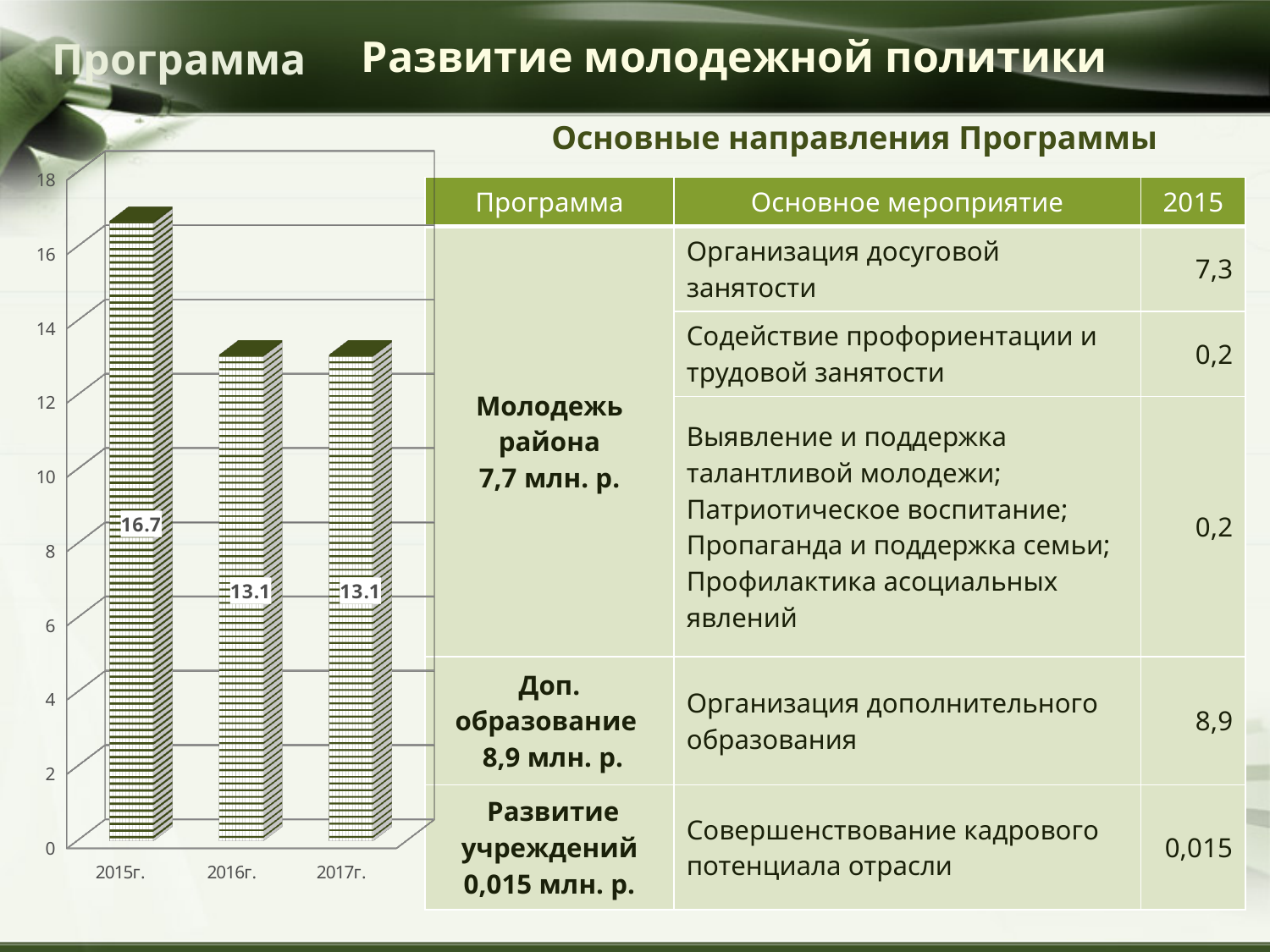
Do the values rise or fall from 2015г. to 2016г.? fall Is the value for 2015г. greater or less than 16? greater What is the maximum value shown on the chart's vertical axis? 18 How many years are shown on the x axis of the chart? 3 What is the value for 2016г.? 13.1 What is the difference between the values for 2015г. and 2016г.? 3.6 Which year has the highest value? 2015г. What kind of chart is shown on the slide? bar chart What is the value for 2015г.? 16.7 Is the value for 2016г. greater or less than 14? less Which is larger, the value for 2015г. or the value for 2017г.? 2015г. What is the value for 2017г.? 13.1